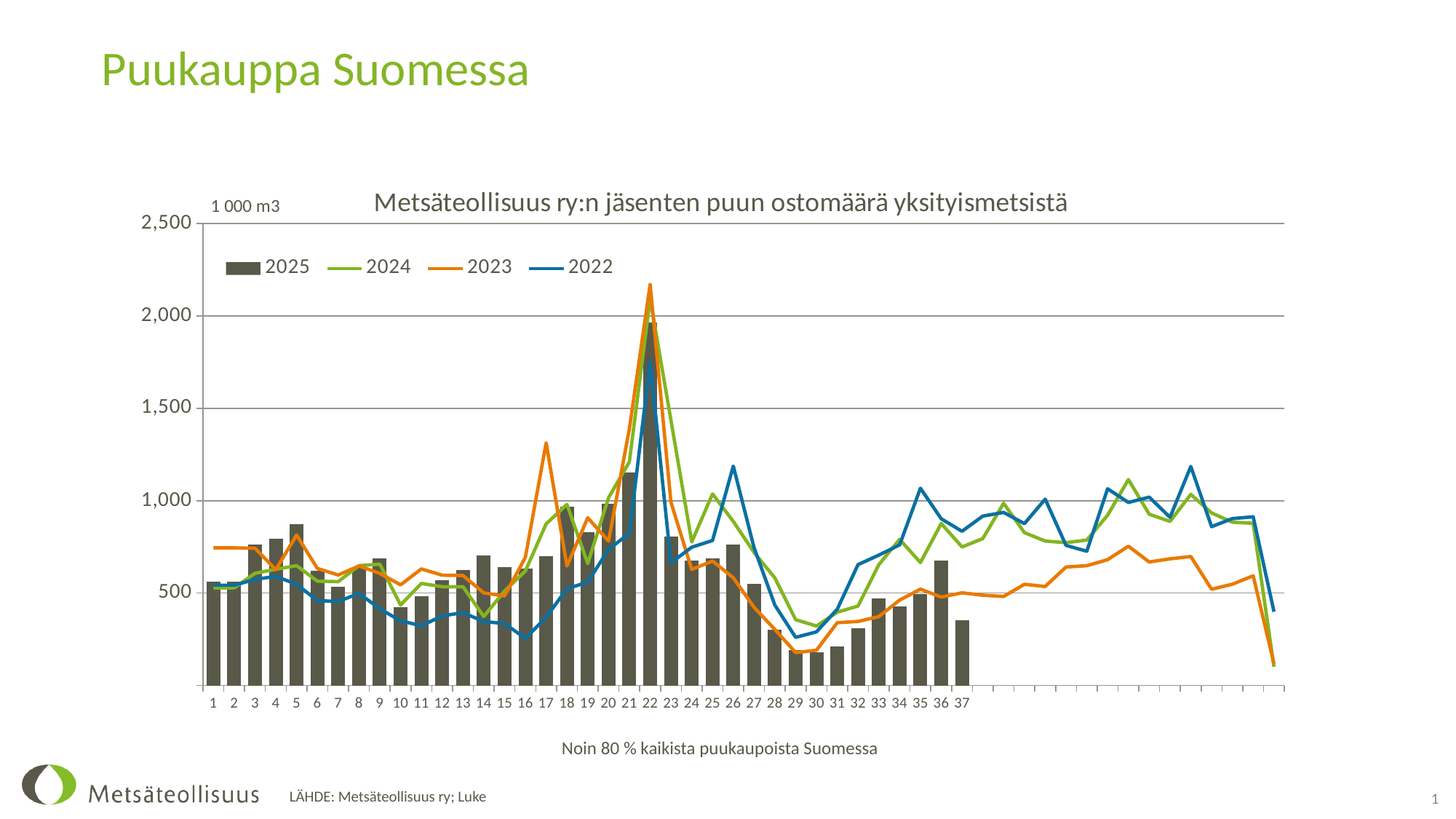
What is the title of the chart? Metsäteollisuus ry:n jäsenten puun ostomäärä yksityismetsistä How many series does the legend list? 4 Do the 2025 bars rise or fall from week 22 to week 30? Fall Which series is drawn as bars rather than a line? 2025 Is the 2025 bar for week 22 greater or less than 1,500? greater Which is larger, the 2025 bar for week 22 or the 2025 bar for week 1? Week 22 At which week number is the 2025 bar highest? 22 Is the 2023 line value at week 17 greater or less than 1,000? greater Is the 2025 bar for week 30 greater or less than 500? less What kind of chart is shown on the slide? A combined bar and line chart